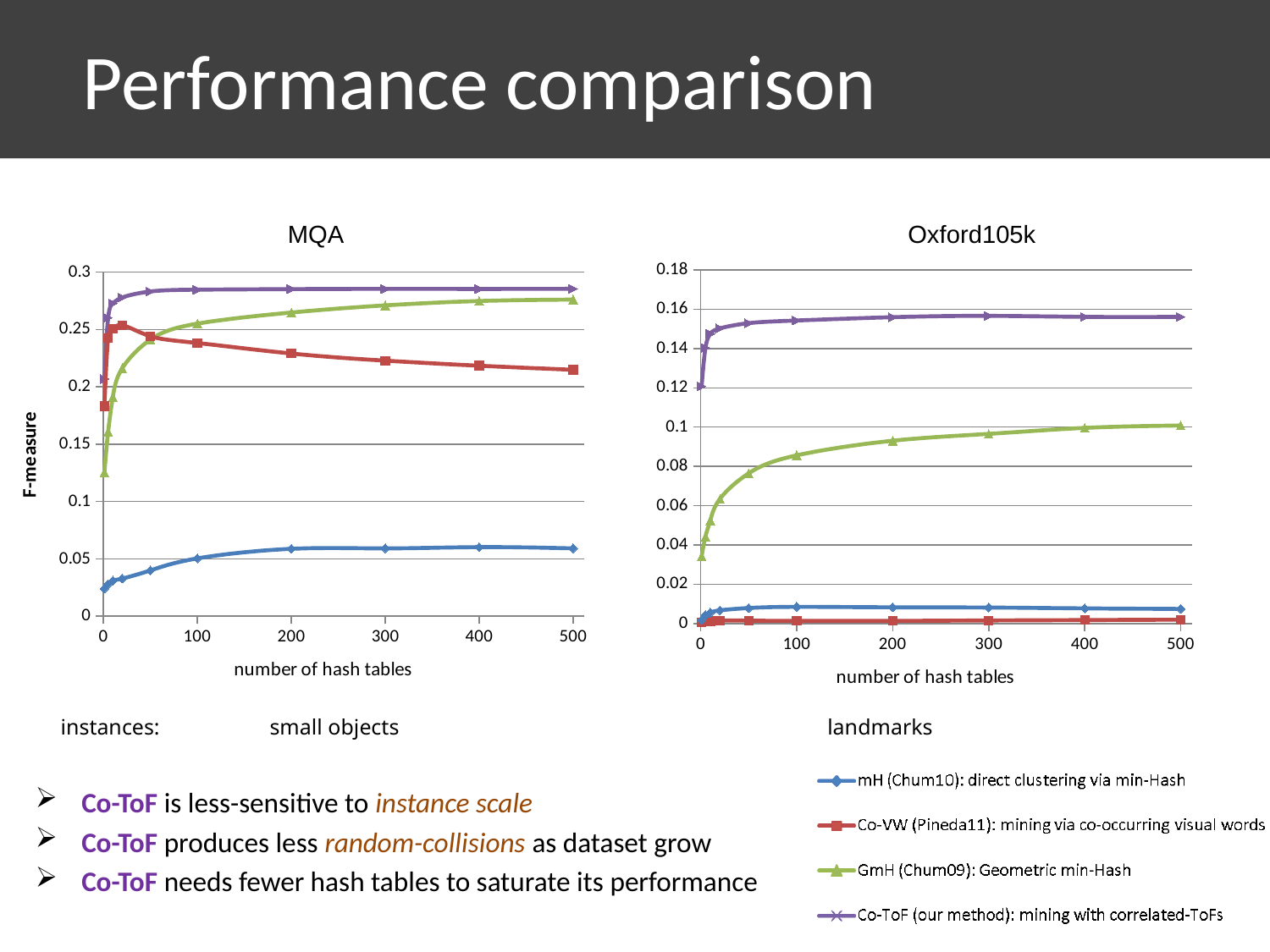
In the Oxford105k chart, which series has the highest F-measure at 500 hash tables? Co-ToF (our method) In the MQA chart, is the F-measure of Co-ToF at 500 hash tables greater or less than 0.25? greater In the Oxford105k chart, which is larger at 500 hash tables: the F-measure of GmH (Chum09) or of mH (Chum10)? GmH (Chum09) In the MQA chart, which series has the highest F-measure at 500 hash tables? Co-ToF (our method) In the MQA chart, is the F-measure of mH (Chum10) at 500 hash tables greater or less than 0.1? less How many series does the legend list for the charts? 4 What kind of chart is the MQA chart? line chart In the Oxford105k chart, which series has the lowest F-measure at 500 hash tables? Co-VW (Pineda11) In the Oxford105k chart, is the F-measure of GmH (Chum09) at 500 hash tables greater or less than 0.12? less In the MQA chart, does the F-measure of Co-VW (Pineda11) rise or fall between 100 and 500 hash tables? fall In the MQA chart, which series has the lowest F-measure at 500 hash tables? mH (Chum10) What is the label of the x axis on the Oxford105k chart? number of hash tables